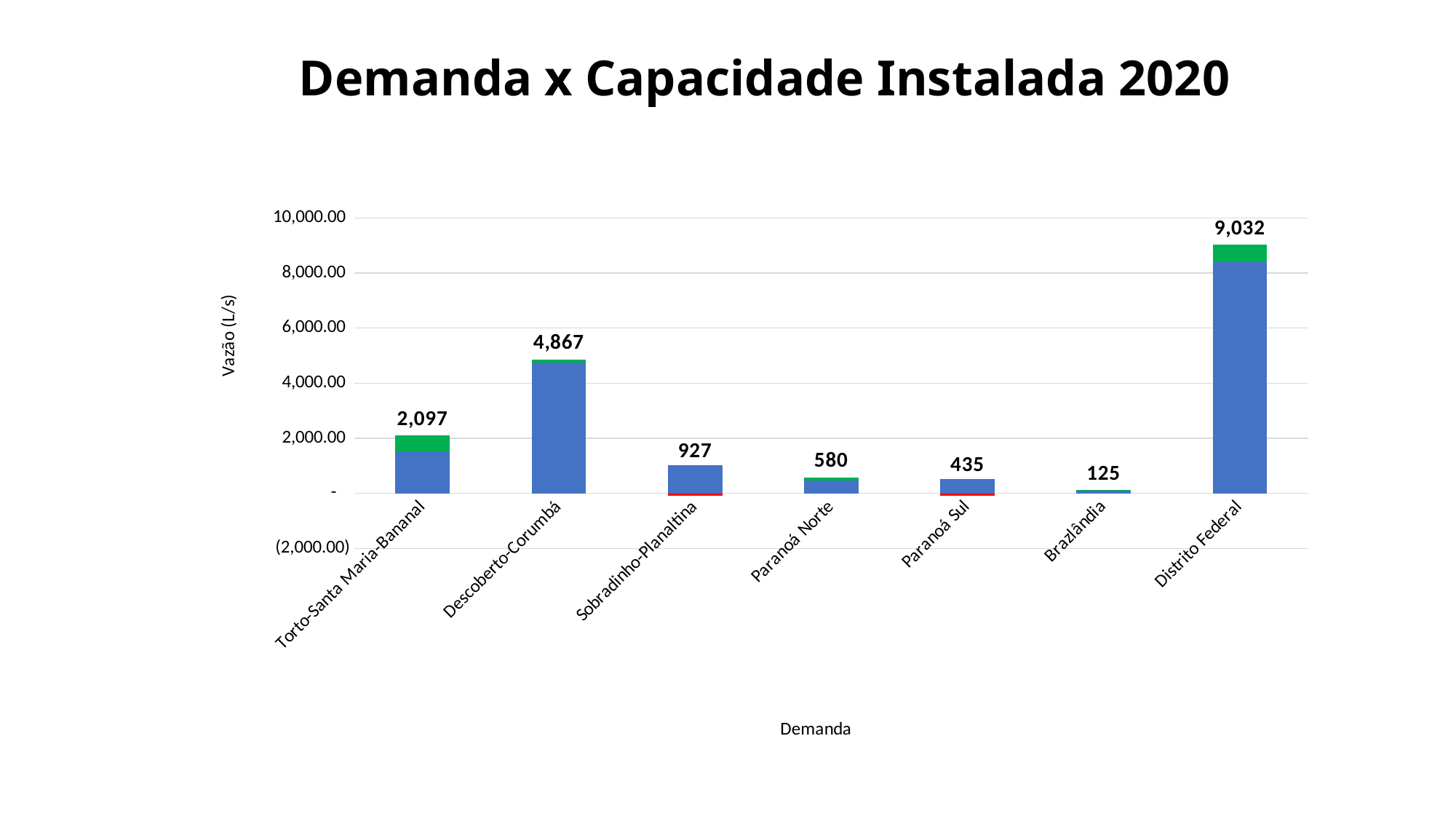
What value is labelled for Distrito Federal? 9,032 What value is labelled for Brazlândia? 125 What is the difference between the labelled values for Distrito Federal and Descoberto-Corumbá? 4,165 Which category has the highest labelled value? Distrito Federal What value is labelled for Paranoá Sul? 435 How many categories are shown on the x axis? 7 Which category has the lowest labelled value? Brazlândia What value is labelled for Descoberto-Corumbá? 4,867 What is the difference between the labelled values for Paranoá Norte and Paranoá Sul? 145 What is the title of the chart? Demanda x Capacidade Instalada 2020 What kind of chart is shown on the slide? Bar chart Which has a larger labelled value, Sobradinho-Planaltina or Paranoá Norte? Sobradinho-Planaltina